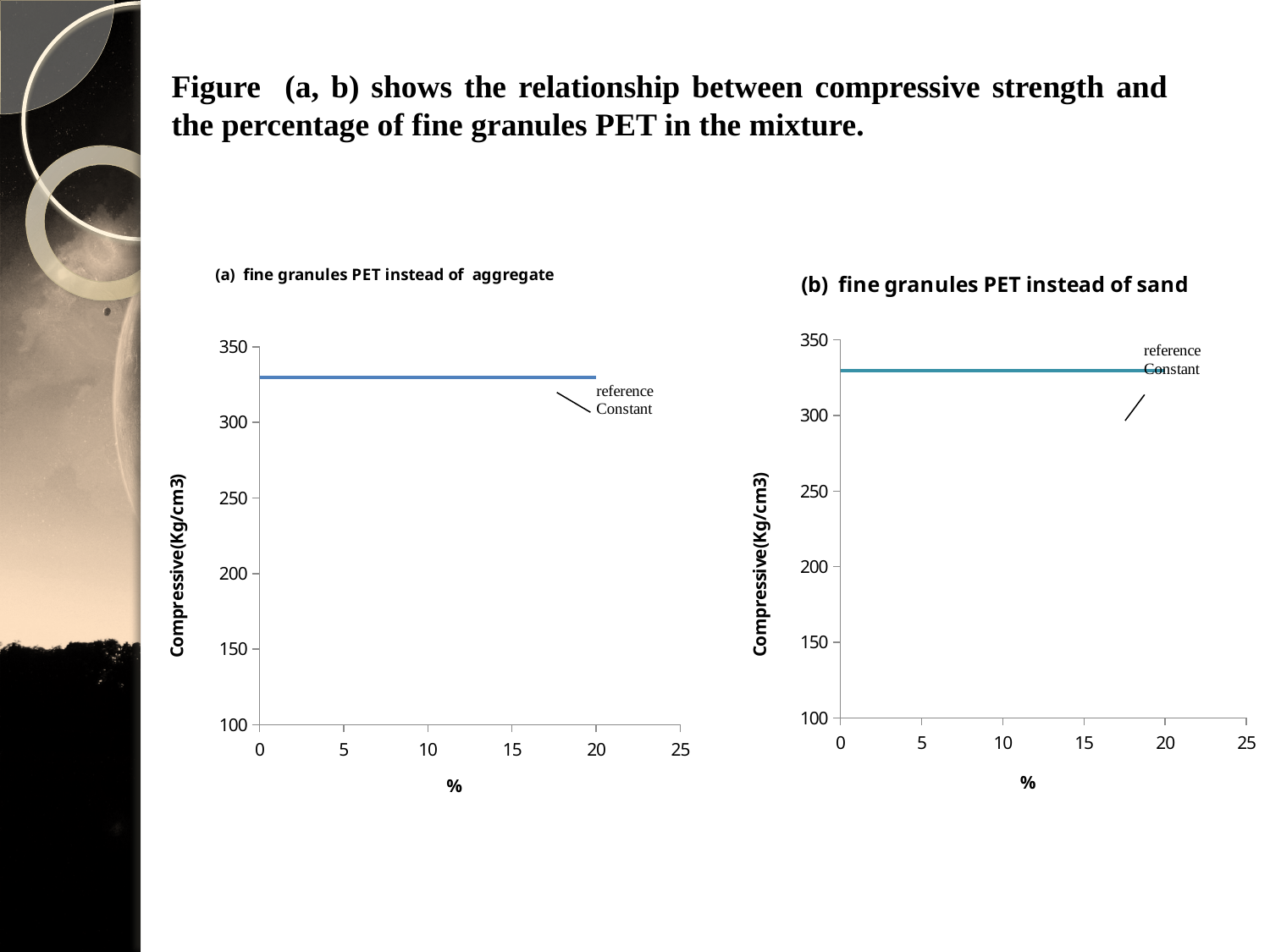
In chart (b) 'fine granules PET instead of sand', does the plotted line rise, fall, or stay flat as the percentage increases? stays flat What kind of chart is chart (b) 'fine granules PET instead of sand'? line chart In chart (a) 'fine granules PET instead of aggregate', is the value of the reference constant line greater or less than 350? less In chart (a) 'fine granules PET instead of aggregate', is the value of the reference constant line greater or less than 300? greater In chart (a) 'fine granules PET instead of aggregate', does the plotted line rise, fall, or stay flat as the percentage increases? stays flat In chart (b) 'fine granules PET instead of sand', is the value of the reference constant line greater or less than 250? greater What kind of chart is chart (a) 'fine granules PET instead of aggregate'? line chart What is the label of the y-axis in chart (a) 'fine granules PET instead of aggregate'? Compressive(Kg/cm3) What is the label of the x-axis in chart (b) 'fine granules PET instead of sand'? %